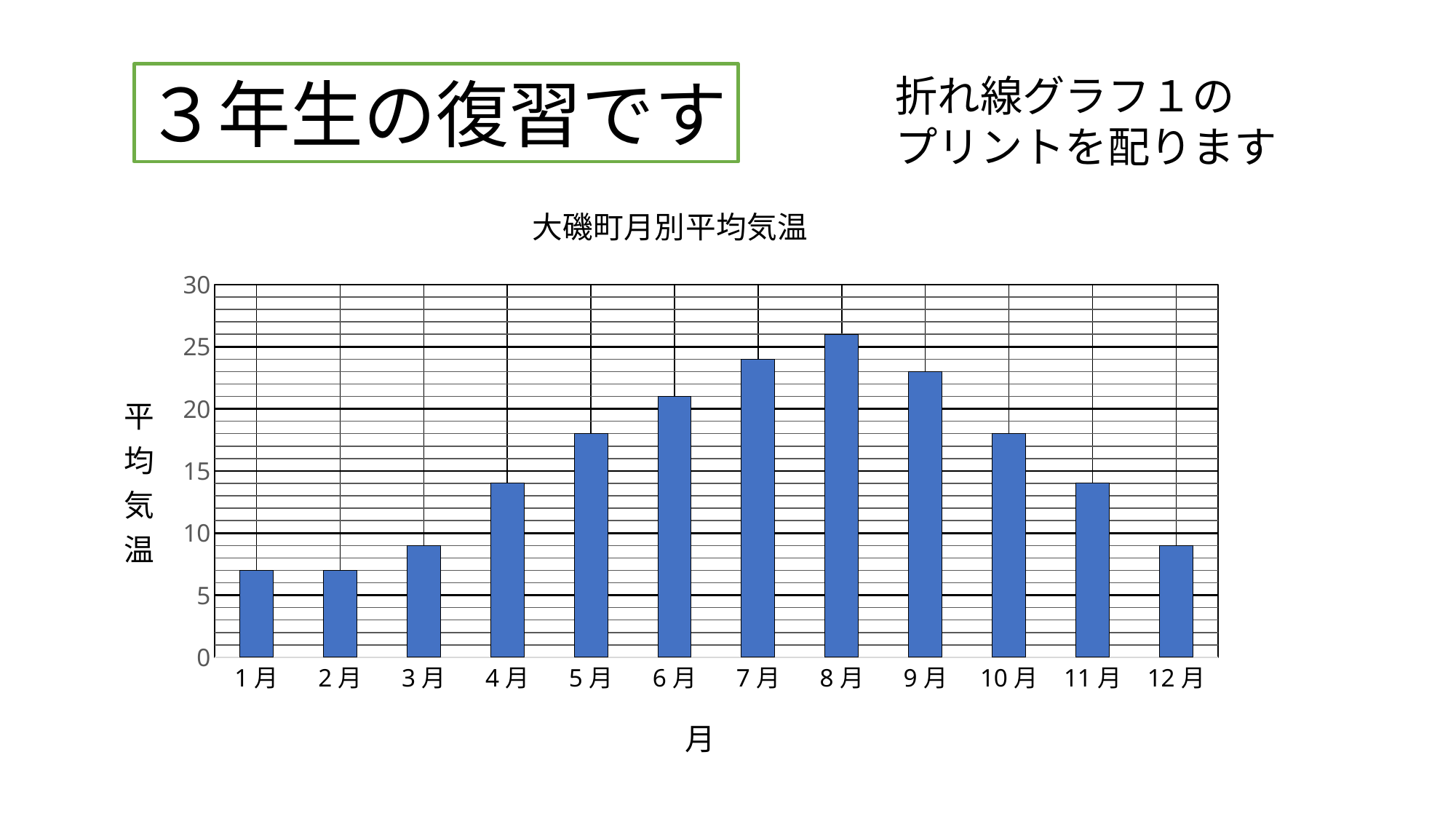
Which month has the highest average temperature? 8月 Is the value for 5月 greater or less than 15? greater Is the value for 12月 greater or less than 10? less What is the title of the chart? 大磯町月別平均気温 Do the values rise or fall from 1月 to 8月? rise What is the label on the vertical axis? 平均気温 Which is larger, the value for 6月 or the value for 10月? 6月 Is the value for 8月 greater or less than 25? greater How many months (categories) are plotted on the x axis? 12 What kind of chart is shown on the slide? bar chart